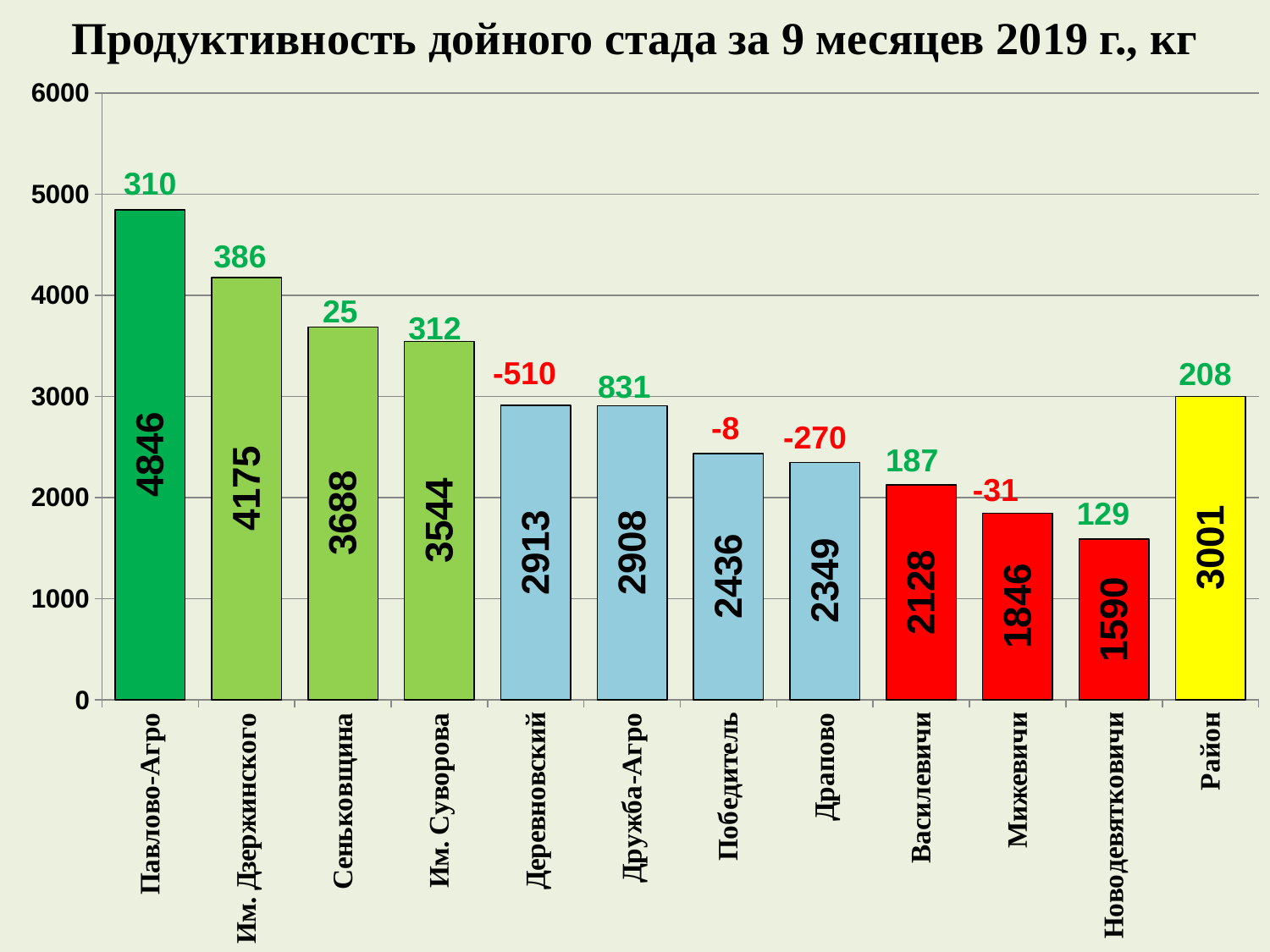
What is the value for Победитель? 2436 What is the value for Район? 3001 How many bars are shown on the chart? 12 Is the value for Василевичи greater or less than 2000? greater Which category has the lowest value? Новодевятковичи What kind of chart is shown on the slide? bar chart What is the value for Павлово-Агро? 4846 What is the difference between the values for Павлово-Агро and Им. Дзержинского? 671 What is the title of the chart? Продуктивность дойного стада за 9 месяцев 2019 г., кг Which category has the highest value? Павлово-Агро Which is larger, the value for Деревновский or the value for Дружба-Агро? Деревновский What colour is the bar for Район? yellow